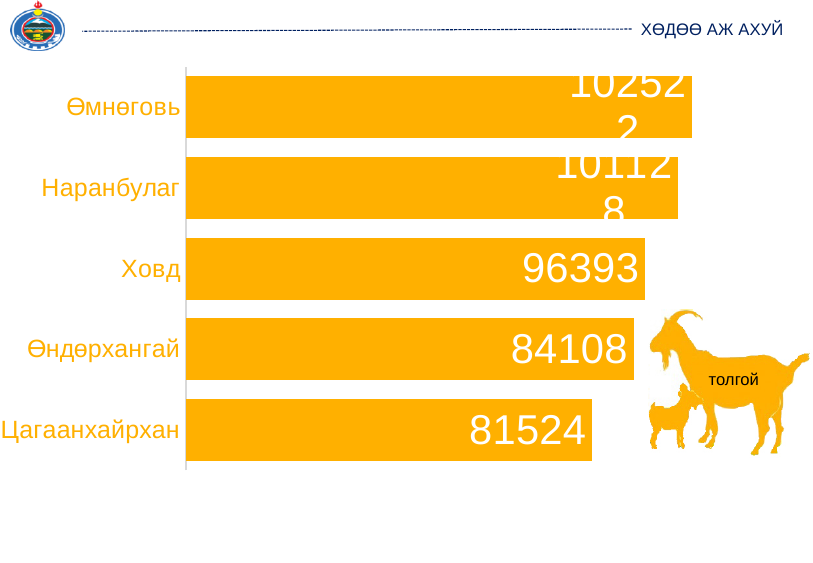
What is the difference between the values for Өндөрхангай and Цагаанхайрхан? 2584 What is the value for Ховд? 96393 How many categories are shown in the chart? 5 What is the value for Цагаанхайрхан? 81524 What is the value for Наранбулаг? 101128 Which is larger, the value for Ховд or the value for Өндөрхангай? Ховд Which category has the lowest value? Цагаанхайрхан What kind of chart is shown on the slide? Bar chart What is the difference between the values for Ховд and Өндөрхангай? 12285 Which category has the highest value? Өмнөговь What is the value for Өндөрхангай? 84108 What is the value for Өмнөговь? 102522